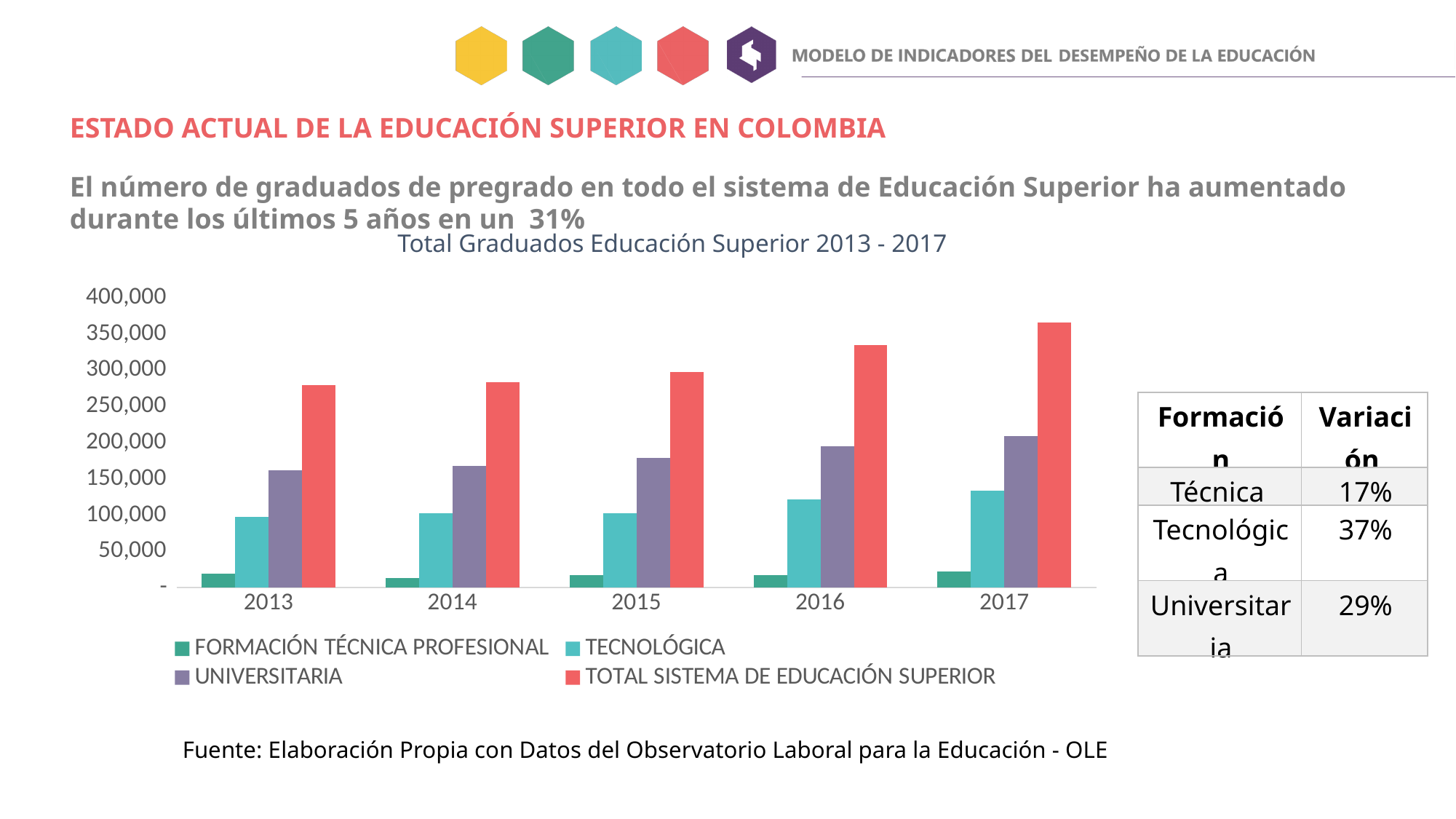
In which year is the TOTAL SISTEMA DE EDUCACIÓN SUPERIOR bar the lowest? 2013 Is the value for TOTAL SISTEMA DE EDUCACIÓN SUPERIOR in 2017 greater or less than 350,000? greater Do the TOTAL SISTEMA DE EDUCACIÓN SUPERIOR values rise or fall from 2013 to 2017? rise How many years are shown on the x axis of the chart? 5 What kind of chart is shown on the slide? Bar chart How many series does the legend of the chart list? 4 In 2017, which is larger: UNIVERSITARIA or TECNOLÓGICA? UNIVERSITARIA What is the title of the chart? Total Graduados Educación Superior 2013 - 2017 Is the value for UNIVERSITARIA in 2017 greater or less than 200,000? greater Is the value for TECNOLÓGICA in 2017 greater or less than 100,000? greater In which year is the TOTAL SISTEMA DE EDUCACIÓN SUPERIOR bar the highest? 2017